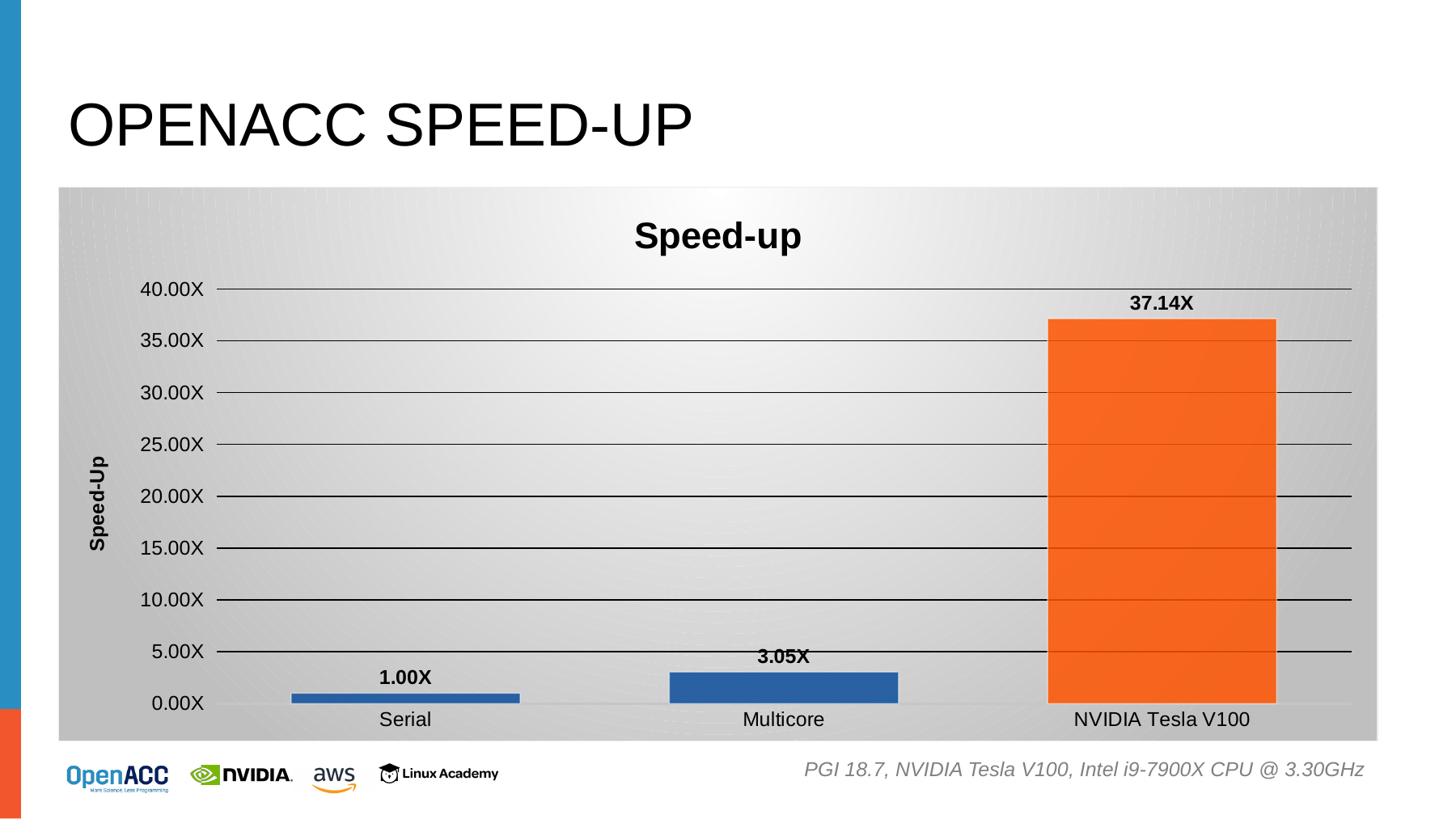
What is the speed-up value for Serial? 1.00X Which category has the highest speed-up? NVIDIA Tesla V100 What is the difference between the speed-up for NVIDIA Tesla V100 and Multicore? 34.09X What is the speed-up value for NVIDIA Tesla V100? 37.14X What is the difference between the speed-up for Multicore and Serial? 2.05X Which has a larger speed-up, Multicore or Serial? Multicore What is the title of the chart? Speed-up What is the speed-up value for Multicore? 3.05X What kind of chart is shown on the slide? bar chart How many categories are shown on the chart? 3 Which category has the lowest speed-up? Serial Is the speed-up for NVIDIA Tesla V100 greater or less than 35.00X? greater